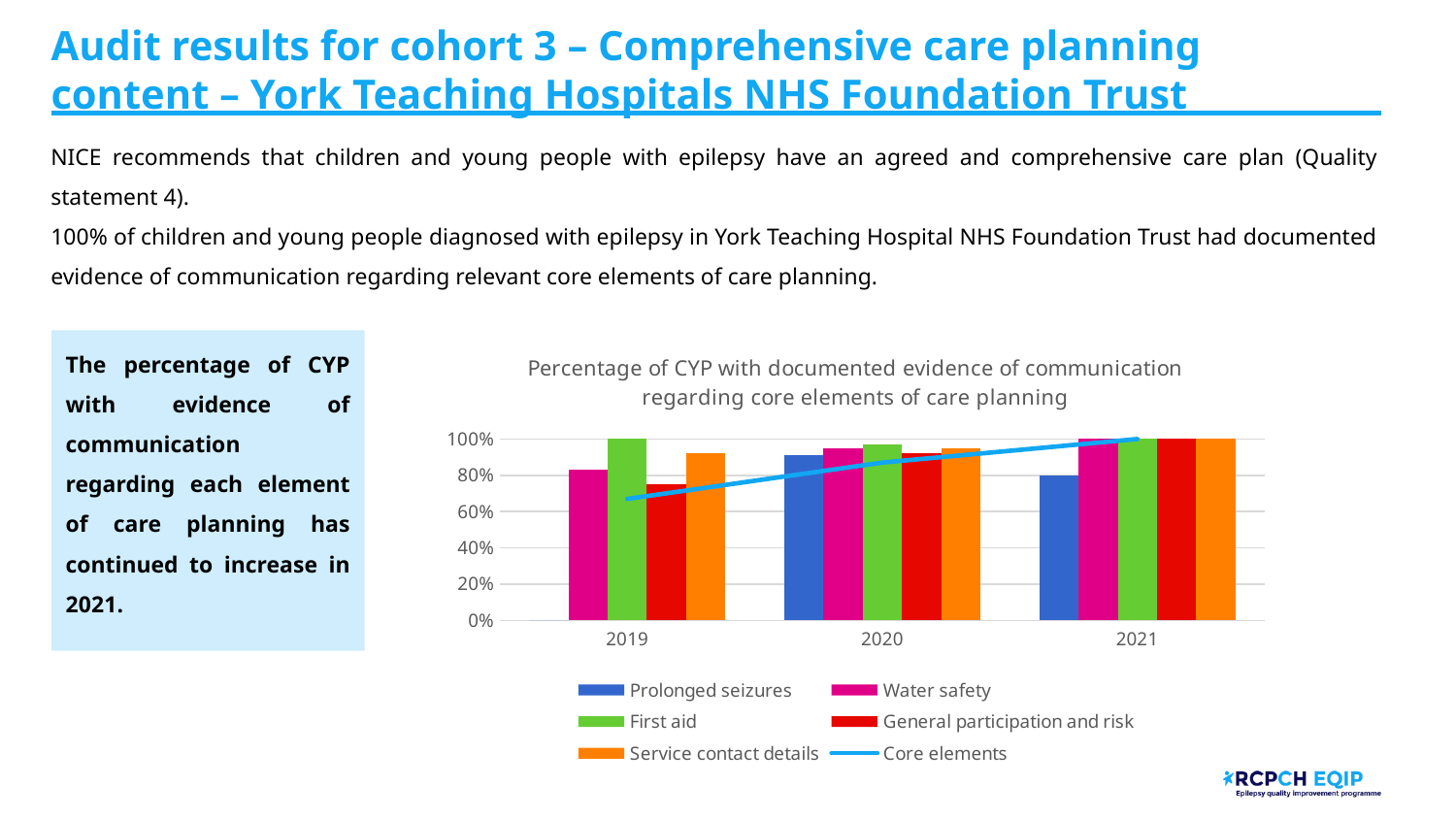
How many series does the chart legend list? 6 In 2019, which series has the highest bar? First aid What colour represents First aid in the chart? green Is the value for Prolonged seizures in 2021 greater or less than 90%? less In 2021, which series has the lowest bar? Prolonged seizures What kind of chart is shown on the slide? bar and line chart Is the value for Prolonged seizures in 2020 greater or less than 80%? greater Is the value for General participation and risk in 2019 greater or less than 80%? less Does the Core elements line rise or fall from 2019 to 2021? rises In 2019, which is larger: Water safety or Service contact details? Service contact details How many years are shown on the x axis of the chart? 3